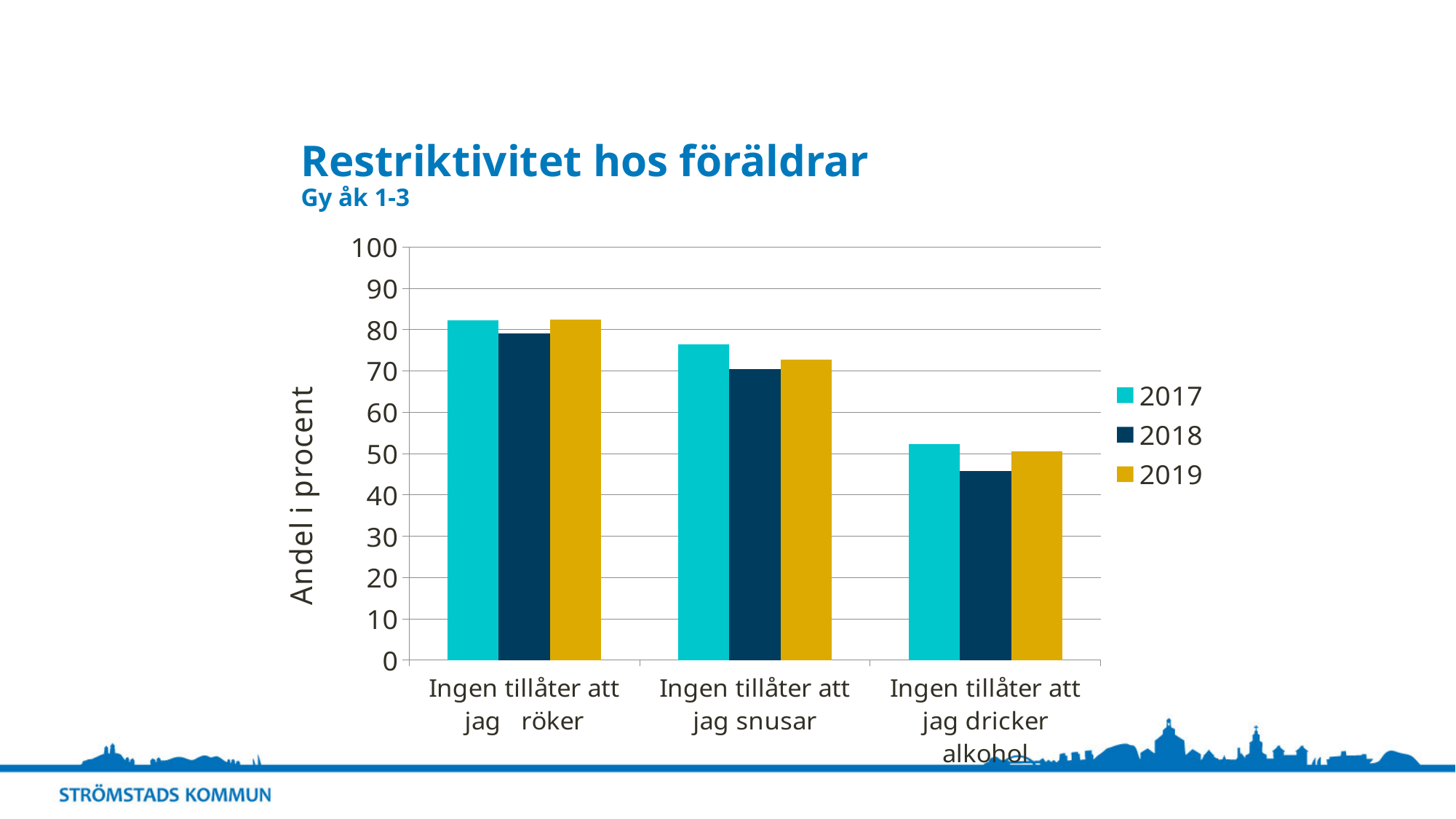
How many categories are shown on the x axis? 3 What kind of chart is shown on the slide? bar chart How many series does the legend list? 3 Which category has the lowest value for 2018? Ingen tillåter att jag dricker alkohol Is the 2017 value for 'Ingen tillåter att jag röker' greater or less than 80? greater What is the label on the vertical axis? Andel i procent Which category has the highest value for 2017? Ingen tillåter att jag röker For 'Ingen tillåter att jag snusar', which is larger, the 2017 value or the 2018 value? 2017 Is the 2018 value for 'Ingen tillåter att jag dricker alkohol' greater or less than 50? less In the category 'Ingen tillåter att jag dricker alkohol', which year has the lowest bar? 2018 Do the 2017 values rise or fall moving from left to right along the x axis? fall Is the 2017 value for 'Ingen tillåter att jag snusar' greater or less than 80? less